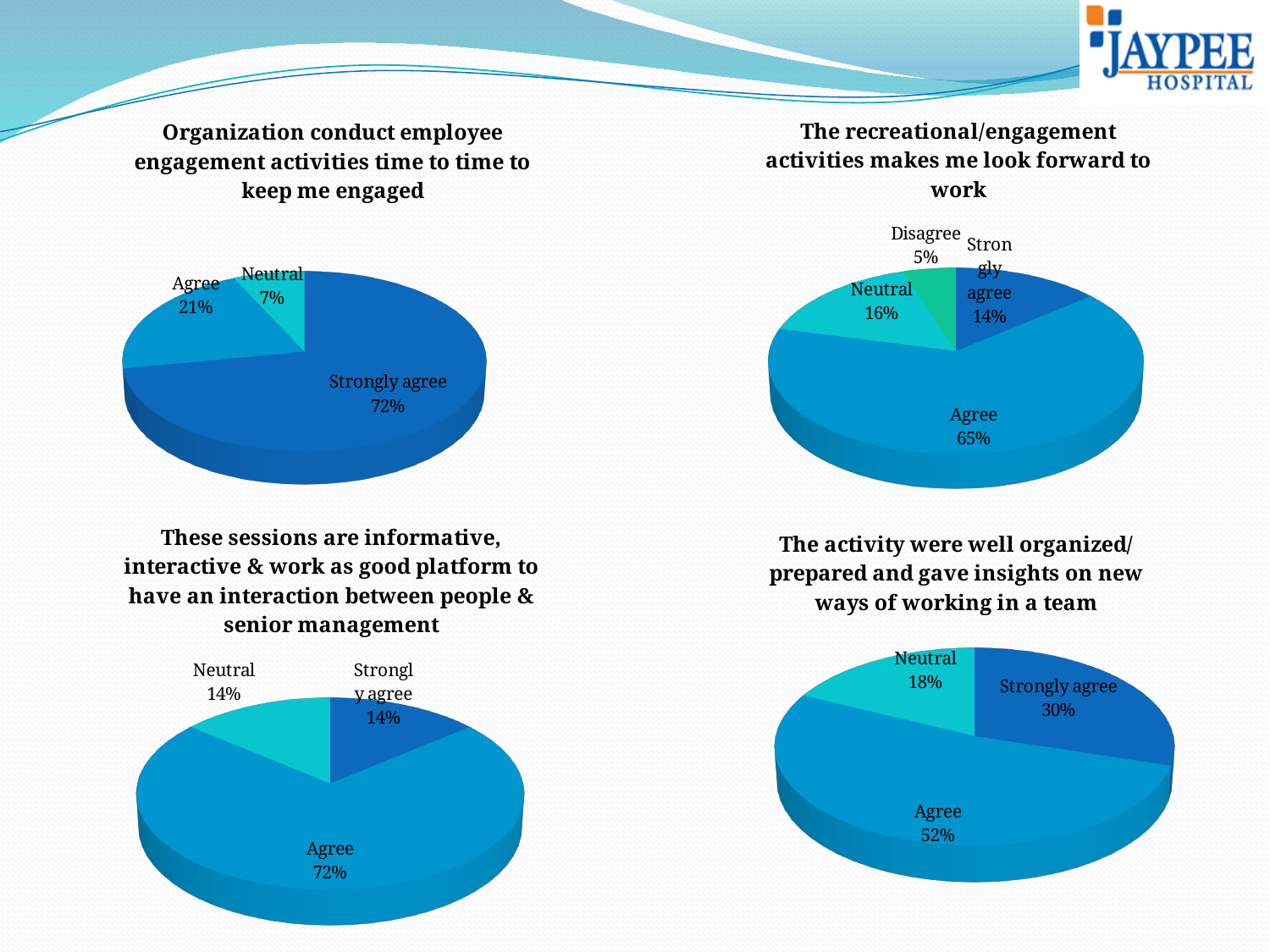
In the bottom-right chart (The activity were well organized/prepared and gave insights on new ways of working in a team), what share is Strongly agree? 30% In the bottom-left chart (These sessions are informative, interactive & work as good platform to have an interaction between people & senior management), which category has the largest share? Agree What kind of chart is used in the bottom-right chart (The activity were well organized/prepared and gave insights on new ways of working in a team)? Pie chart In the top-right chart (The recreational/engagement activities makes me look forward to work), how many slices does the pie have? 4 In the top-left chart (Organization conduct employee engagement activities time to time to keep me engaged), what share is Strongly agree? 72% In the top-right chart (The recreational/engagement activities makes me look forward to work), which category has the smallest share? Disagree In the bottom-right chart (The activity were well organized/prepared and gave insights on new ways of working in a team), which is larger, Agree or Neutral? Agree In the top-left chart (Organization conduct employee engagement activities time to time to keep me engaged), how many slices does the pie have? 3 In the top-left chart (Organization conduct employee engagement activities time to time to keep me engaged), what is the value for Neutral? 7% In the bottom-left chart (These sessions are informative, interactive & work as good platform to have an interaction between people & senior management), what is the value for Neutral? 14% In the top-right chart (The recreational/engagement activities makes me look forward to work), what is the value for Neutral? 16% In the top-right chart (The recreational/engagement activities makes me look forward to work), what is the difference between Agree and Strongly agree? 51%